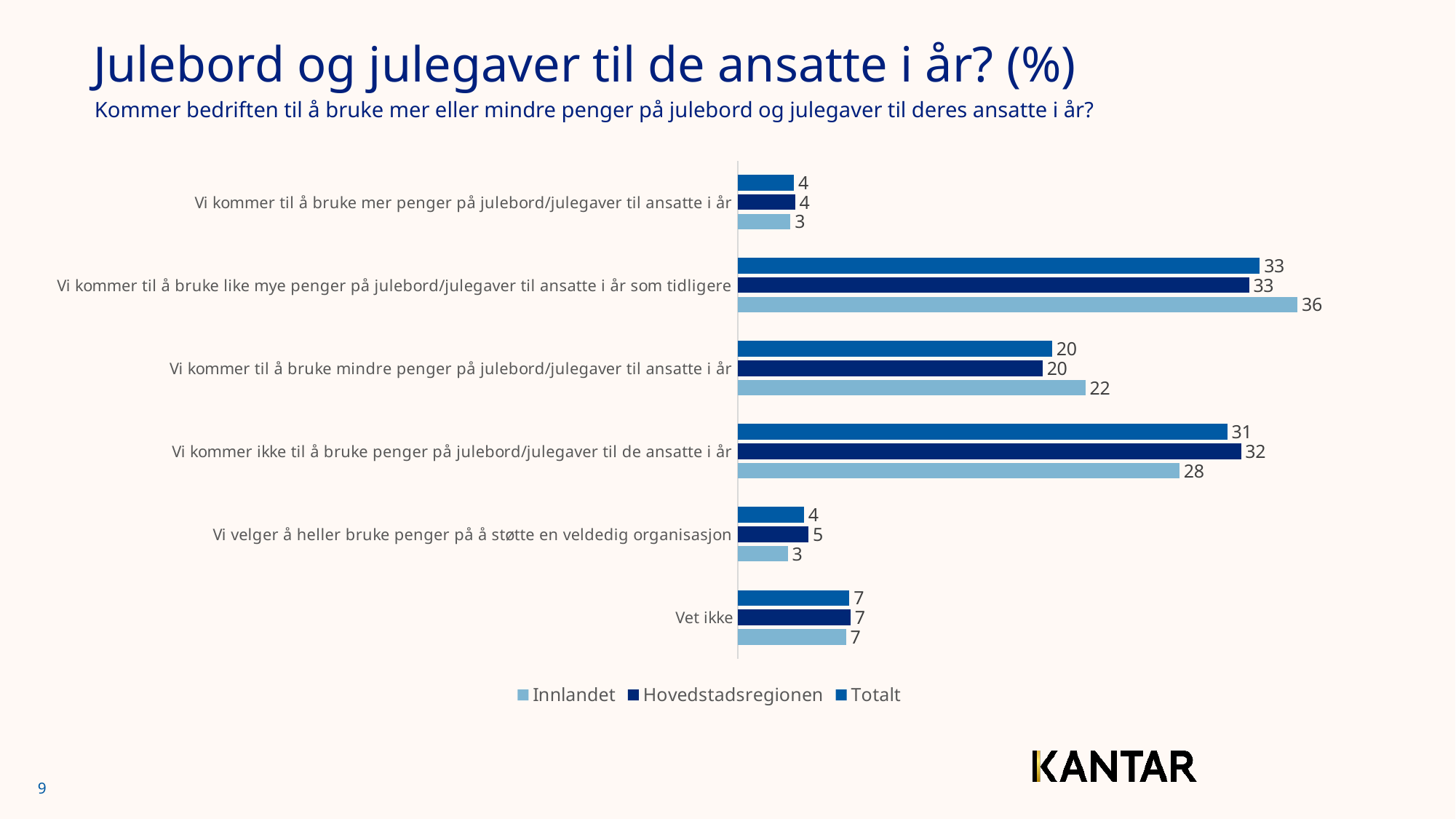
What is the difference between the Innlandet and Hovedstadsregionen values for "Vi kommer ikke til å bruke penger på julebord/julegaver til de ansatte i år"? 4 How many categories are shown on the chart? 6 For "Vi kommer til å bruke mindre penger på julebord/julegaver til ansatte i år", which is larger: the Innlandet value or the Totalt value? Innlandet What is the Hovedstadsregionen value for "Vi kommer ikke til å bruke penger på julebord/julegaver til de ansatte i år"? 32 What is the Innlandet value for "Vi kommer til å bruke like mye penger på julebord/julegaver til ansatte i år som tidligere"? 36 How many series does the legend list? 3 Which series is shown in the lightest blue colour in the legend? Innlandet What is the Totalt value for "Vi kommer til å bruke mindre penger på julebord/julegaver til ansatte i år"? 20 What is the Innlandet value for "Vi velger å heller bruke penger på å støtte en veldedig organisasjon"? 3 What kind of chart is shown on the slide? Bar chart Which category has the highest Innlandet value? Vi kommer til å bruke like mye penger på julebord/julegaver til ansatte i år som tidligere Which category has the lowest Hovedstadsregionen value? Vi kommer til å bruke mer penger på julebord/julegaver til ansatte i år